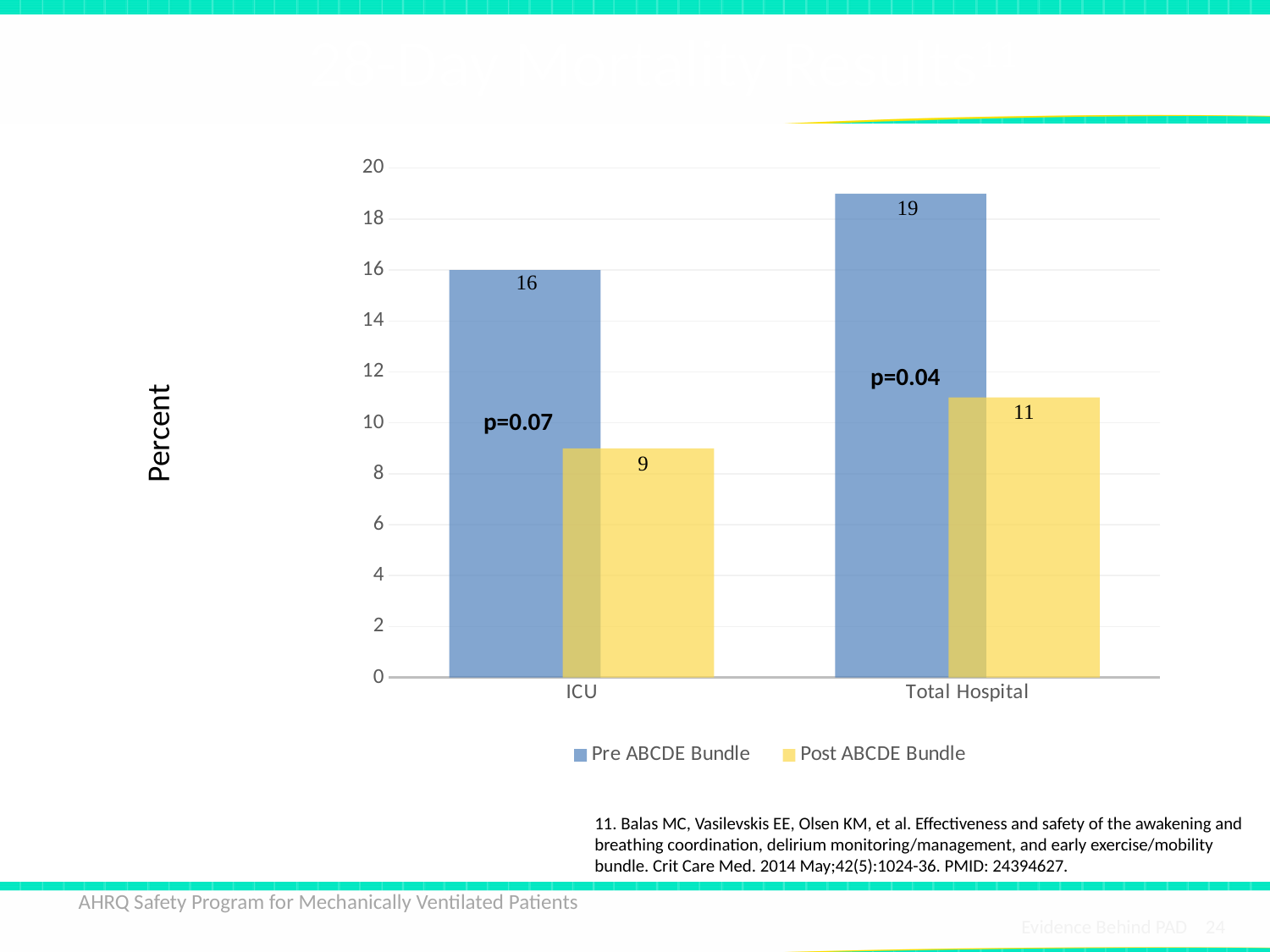
What is the Post ABCDE Bundle value for ICU? 9 What is the Pre ABCDE Bundle value for Total Hospital? 19 What kind of chart is shown on the slide? Bar chart What is the Pre ABCDE Bundle value for ICU? 16 What is the difference between the Pre and Post ABCDE Bundle values for Total Hospital? 8 What is the difference between the Pre and Post ABCDE Bundle values for ICU? 7 How many categories are shown on the x axis? 2 How many series does the legend list? 2 Which category has the highest Pre ABCDE Bundle value? Total Hospital What is the Post ABCDE Bundle value for Total Hospital? 11 Which is larger for Total Hospital, the Pre ABCDE Bundle value or the Post ABCDE Bundle value? Pre ABCDE Bundle Which category has the lowest Post ABCDE Bundle value? ICU